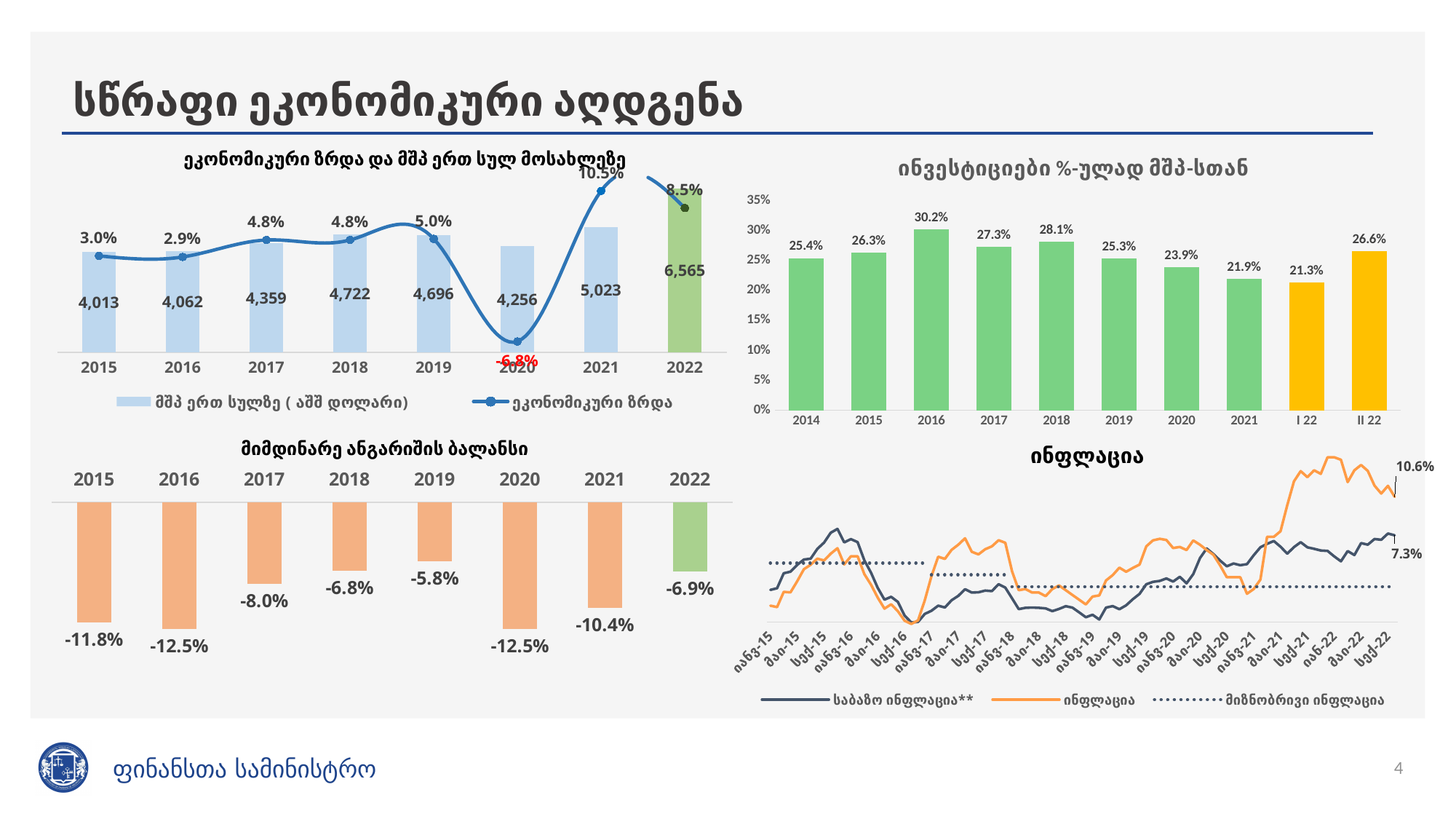
In the top-right chart, which category has the lowest value? I 22 In the top-left chart, what economic growth rate is shown for 2020? -6.8% In the top-left chart, what is the GDP per capita value shown for 2018? 4,722 What kind of chart is the bottom-right chart? line chart In the top-left chart, what is the difference between the GDP per capita values for 2021 and 2020? 767 In the top-left chart, which year has the highest GDP per capita bar? 2022 In the top-right chart, is the value for 2021 larger or smaller than the value for 2018? smaller In the top-right chart, what is the value shown for 2016? 30.2% In the bottom-left chart, what is the value shown for 2019? -5.8% In the bottom-left chart, what is the difference between the values for 2016 and 2017? 4.5 percentage points In the top-left chart, how many series does the legend list? 2 In the top-right chart, how many bars are plotted? 10